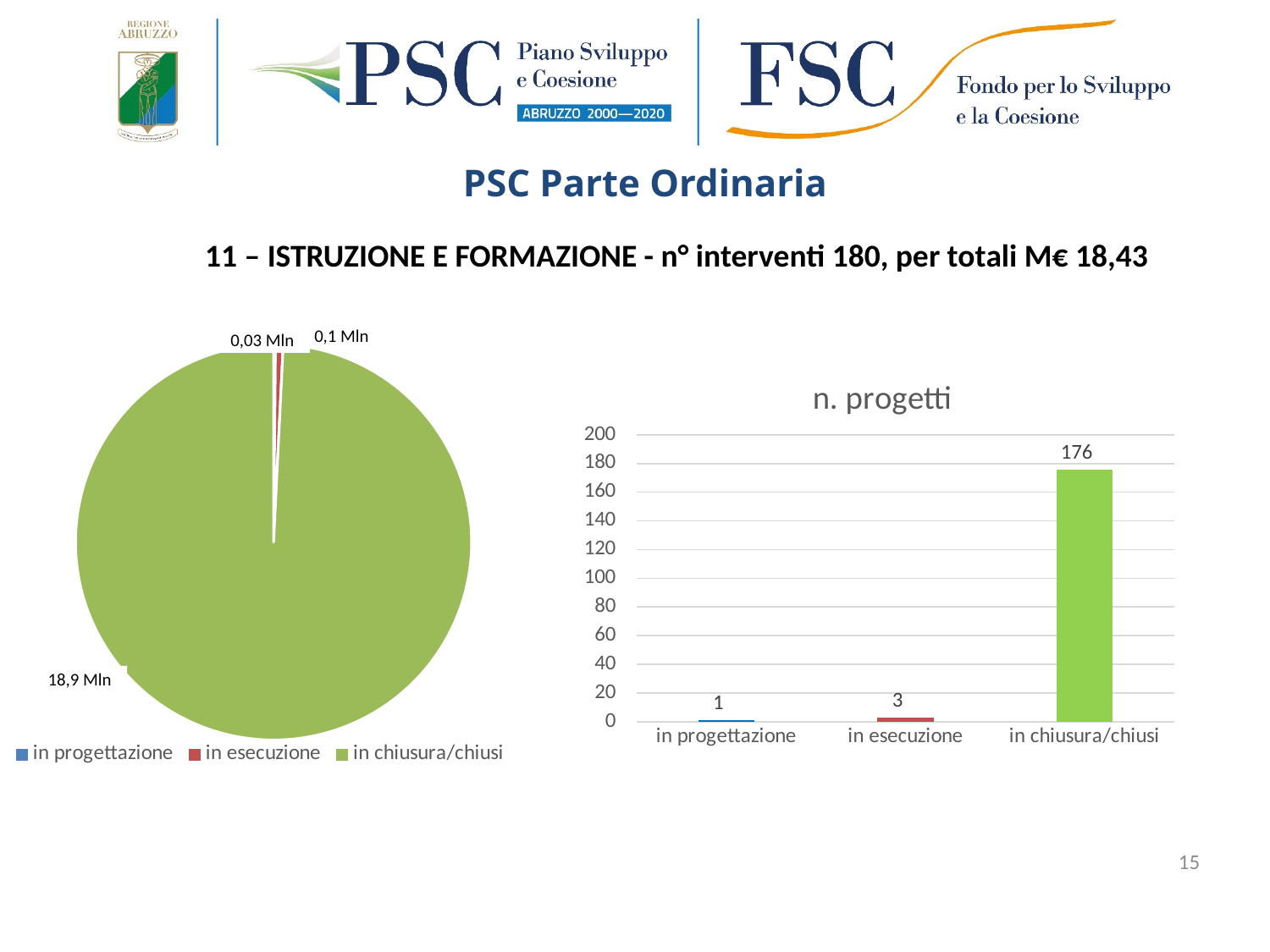
In the bar chart titled 'n. progetti', which category has the highest value? in chiusura/chiusi What kind of chart is the chart on the right of the slide? bar chart In the pie chart on the left, what is the value labelled for the 'in chiusura/chiusi' slice? 18,9 Mln In the bar chart titled 'n. progetti', what is the value for 'in esecuzione'? 3 In the bar chart titled 'n. progetti', what is the difference between the values for 'in chiusura/chiusi' and 'in esecuzione'? 173 How many entries does the legend of the pie chart on the left list? 3 In the bar chart titled 'n. progetti', what is the value for 'in chiusura/chiusi'? 176 In the bar chart titled 'n. progetti', is the value for 'in chiusura/chiusi' greater or less than 160? greater In the bar chart titled 'n. progetti', what is the value for 'in progettazione'? 1 What kind of chart is the chart on the left of the slide? pie chart How many categories are shown in the bar chart titled 'n. progetti'? 3 In the bar chart titled 'n. progetti', which category has the lowest value? in progettazione